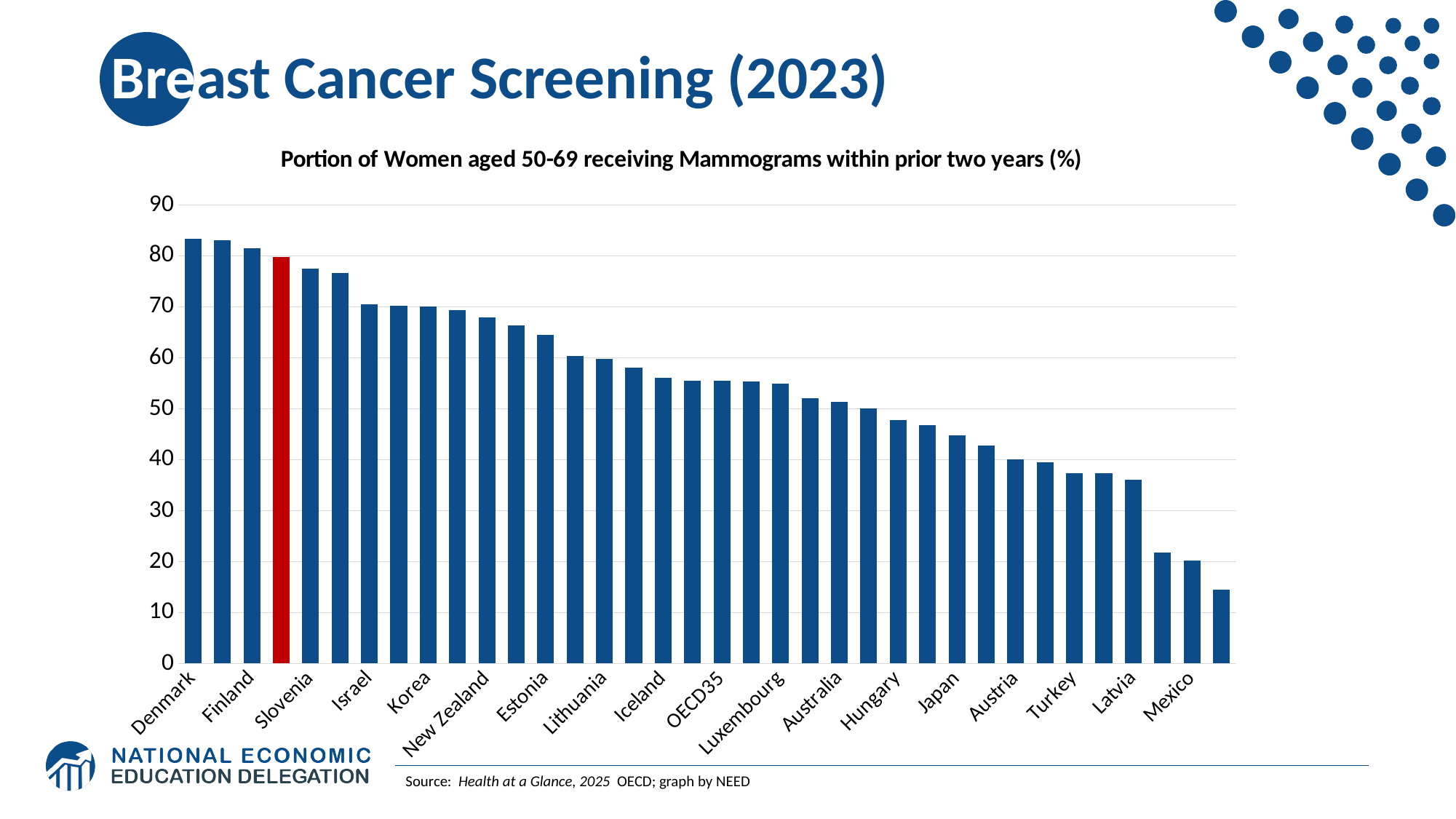
Which has the larger value, Estonia or Lithuania? Estonia What is the title of the chart? Portion of Women aged 50-69 receiving Mammograms within prior two years (%) Is the value for Hungary greater or less than 50? less Is the value for Latvia greater or less than 40? less Is the value for Slovenia greater or less than 70? greater How many bars are coloured red? 1 Do the values rise or fall moving from left to right along the x axis? Fall Which has the larger value, Japan or Hungary? Hungary What kind of chart is shown on the slide? Bar chart